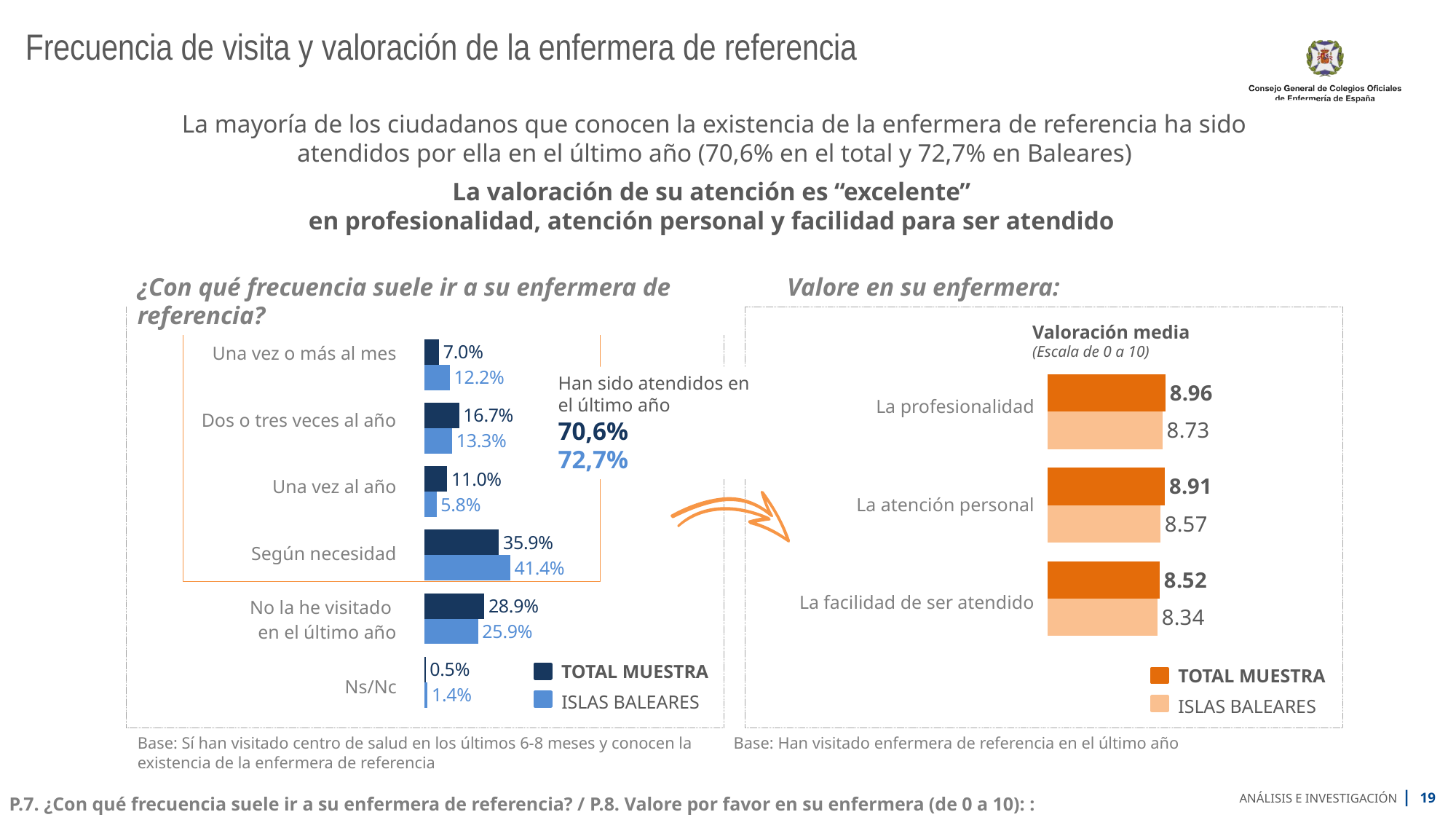
In the left chart (¿Con qué frecuencia suele ir a su enfermera de referencia?), what is the TOTAL MUESTRA value for 'Según necesidad'? 35.9% In the left chart (¿Con qué frecuencia suele ir a su enfermera de referencia?), which category has the lowest TOTAL MUESTRA value? Ns/Nc In the left chart (¿Con qué frecuencia suele ir a su enfermera de referencia?), what is the ISLAS BALEARES value for 'Una vez o más al mes'? 12.2% In the left chart (¿Con qué frecuencia suele ir a su enfermera de referencia?), which is larger for 'Dos o tres veces al año': TOTAL MUESTRA or ISLAS BALEARES? TOTAL MUESTRA In the right chart (Valore en su enfermera), what is the ISLAS BALEARES rating for 'La facilidad de ser atendido'? 8.34 What type of chart is the right chart (Valore en su enfermera)? Bar chart In the left chart (¿Con qué frecuencia suele ir a su enfermera de referencia?), what is the difference between the TOTAL MUESTRA and ISLAS BALEARES values for 'Una vez al año'? 5.2 percentage points In the right chart (Valore en su enfermera), what is the TOTAL MUESTRA rating for 'La atención personal'? 8.91 In the right chart (Valore en su enfermera), which aspect has the highest TOTAL MUESTRA rating? La profesionalidad In the right chart (Valore en su enfermera), what is the difference between the TOTAL MUESTRA and ISLAS BALEARES ratings for 'La profesionalidad'? 0.23 In the left chart (¿Con qué frecuencia suele ir a su enfermera de referencia?), which category has the highest ISLAS BALEARES value? Según necesidad How many categories are shown in the left chart (¿Con qué frecuencia suele ir a su enfermera de referencia?)? 6